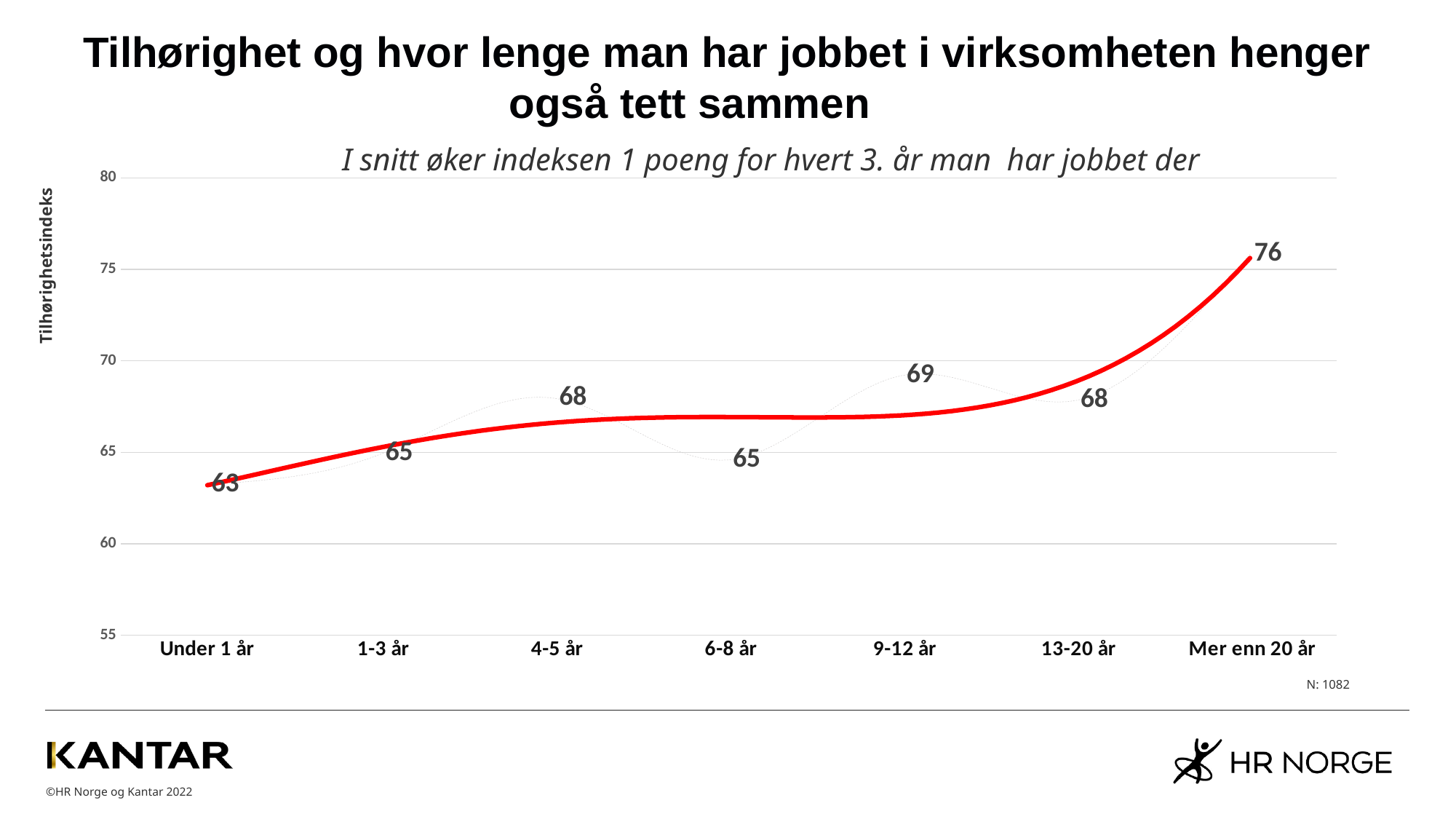
Which category has the highest value? Mer enn 20 år What is the value for "9-12 år"? 69 What is the label of the y axis? Tilhørighetsindeks How many categories are shown on the x axis? 7 What kind of chart is shown on the slide? line chart What is the value for "6-8 år"? 65 Is the value for "Mer enn 20 år" greater or less than 75? greater What is the difference between the values for "Mer enn 20 år" and "Under 1 år"? 13 Which category has the lowest value? Under 1 år What is the value for "Under 1 år"? 63 Which is larger, the value for "4-5 år" or the value for "6-8 år"? 4-5 år What is the value for "Mer enn 20 år"? 76